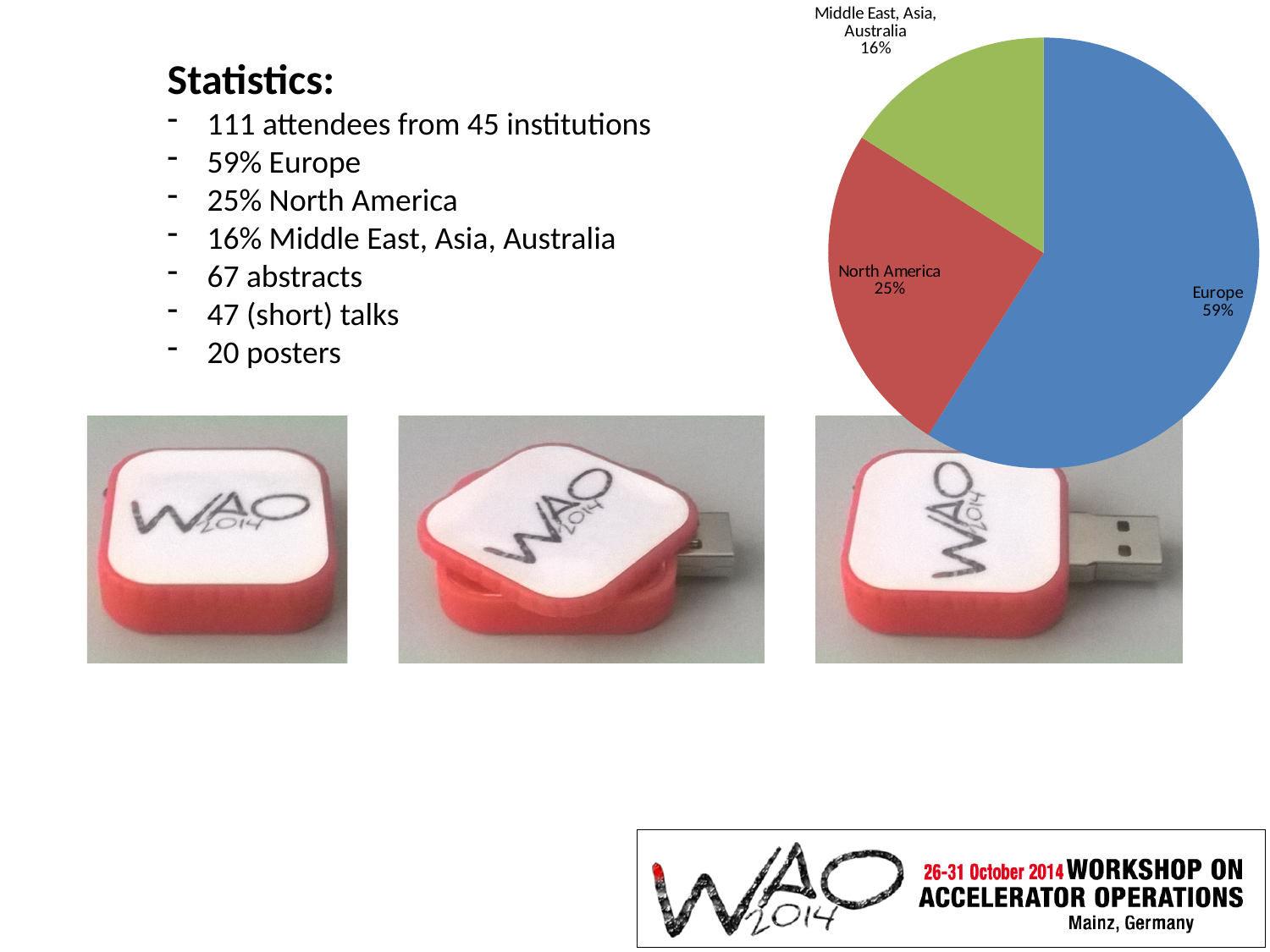
What share of the pie does Europe have? 59% Which slice of the pie chart is the largest? Europe What is the difference in percentage points between the North America slice and the Middle East, Asia, Australia slice? 9 Which is larger, the North America slice or the Middle East, Asia, Australia slice? North America What is the difference in percentage points between the Europe slice and the North America slice? 34 What kind of chart is shown on the slide? pie chart What share of the pie does North America have? 25% How many slices does the pie chart have? 3 Which slice of the pie chart is the smallest? Middle East, Asia, Australia What colour is the Europe slice in the pie chart? blue What share of the pie does Middle East, Asia, Australia have? 16% What colour is the North America slice in the pie chart? red